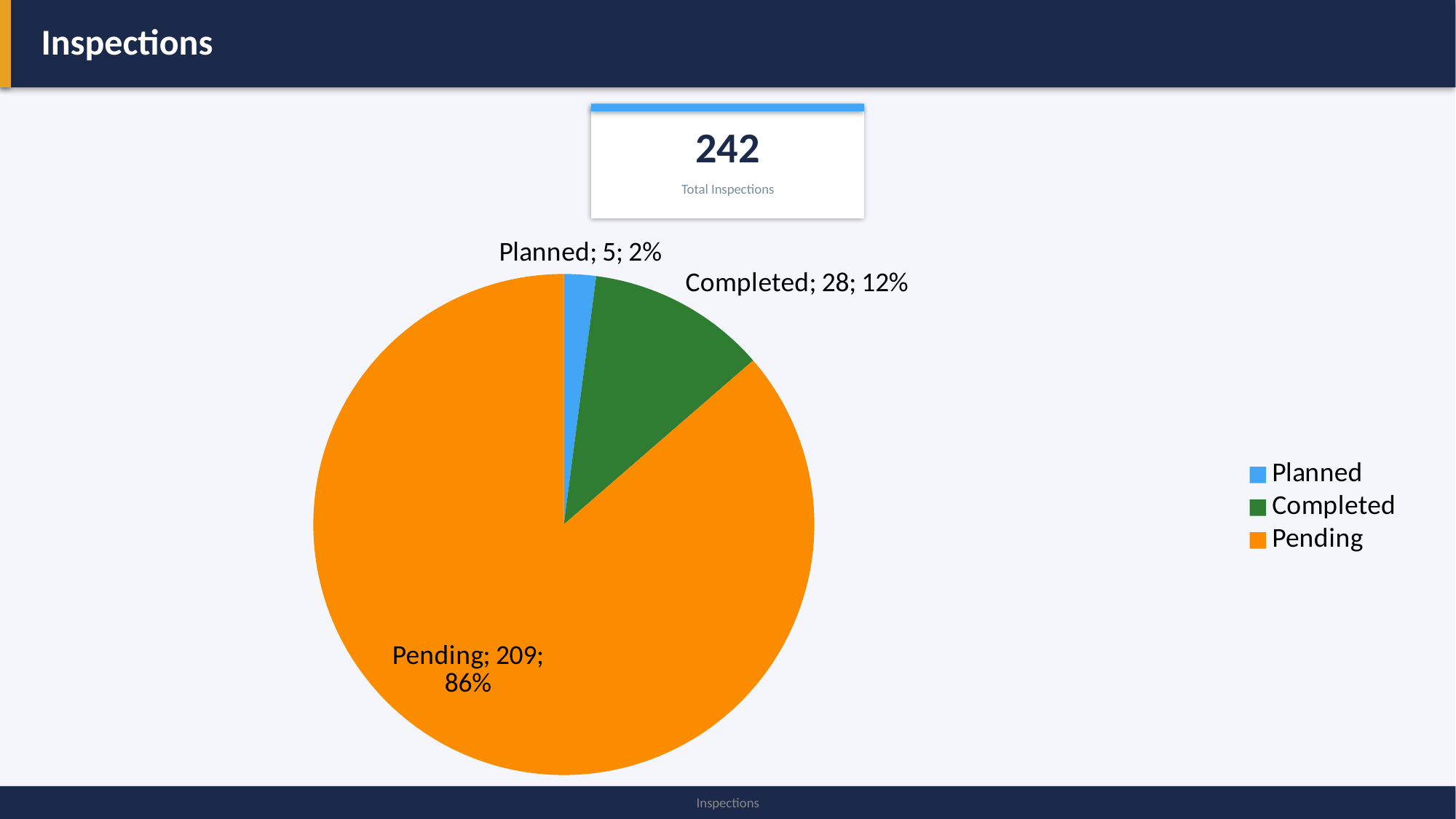
How many inspections are Pending? 209 How many inspections are Planned? 5 How many categories does the pie chart have? 3 How many inspections are Completed? 28 What kind of chart is shown on the slide? pie chart What share of the pie does the Pending slice represent? 86% What is the difference between the number of Pending and Completed inspections? 181 What is the total number of inspections shown in the box above the chart? 242 Which category has the largest slice of the pie? Pending Which category has the smallest slice of the pie? Planned What share of the pie does the Planned slice represent? 2% What share of the pie does the Completed slice represent? 12%